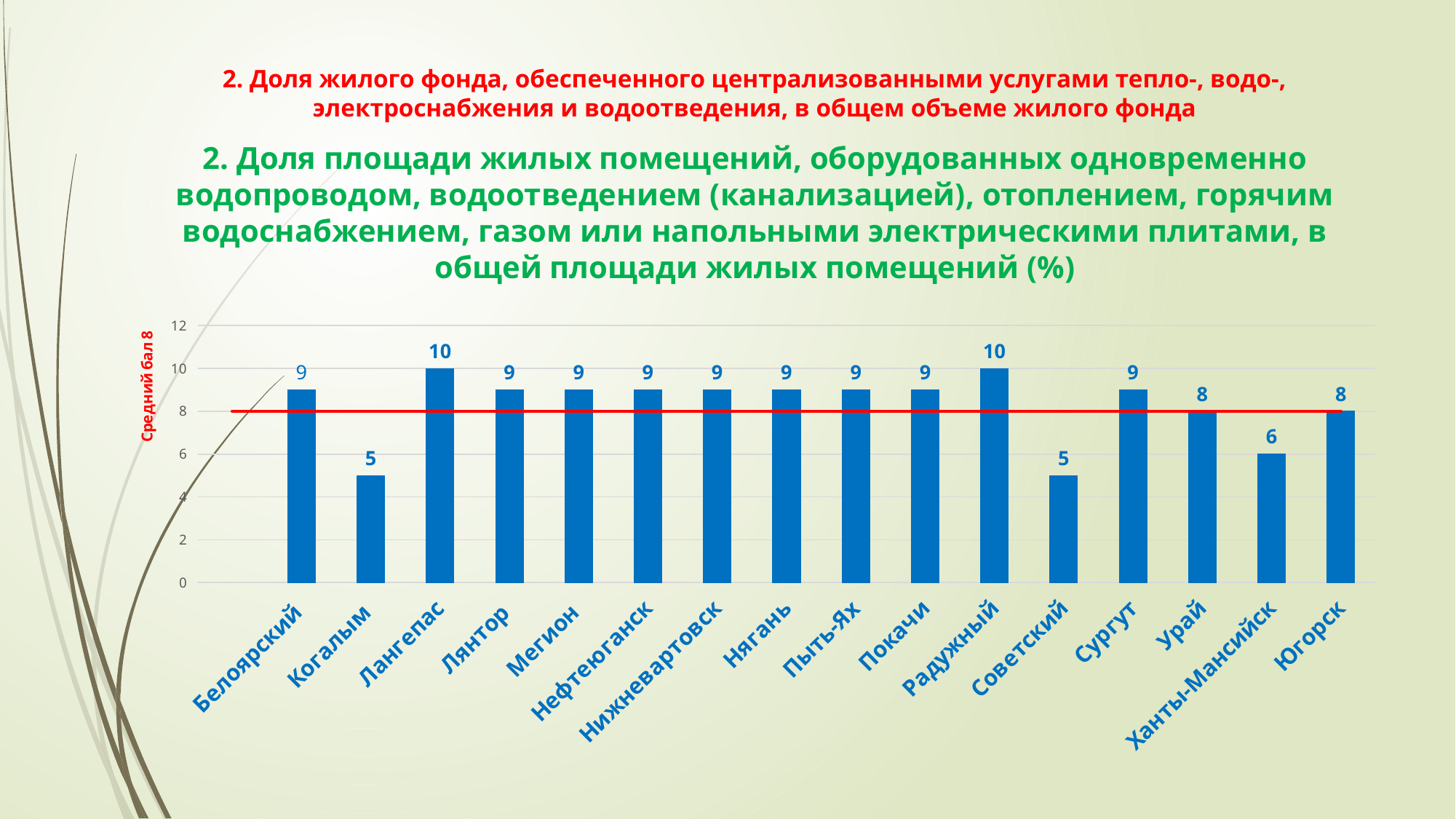
Which two categories have the lowest value? Когалым and Советский What is the value for Ханты-Мансийск? 6 How many categories are shown on the x axis? 16 What is the value for Лангепас? 10 Which is larger, the value for Сургут or the value for Ханты-Мансийск? Сургут What is the difference between the values for Радужный and Советский? 5 What value does the red horizontal line mark, according to its label? 8 Is the value for Когалым greater or less than 8? less What is the value for Когалым? 5 What is the value for Урай? 8 Which two categories have the highest value? Лангепас and Радужный What kind of chart is shown on the slide? Bar chart